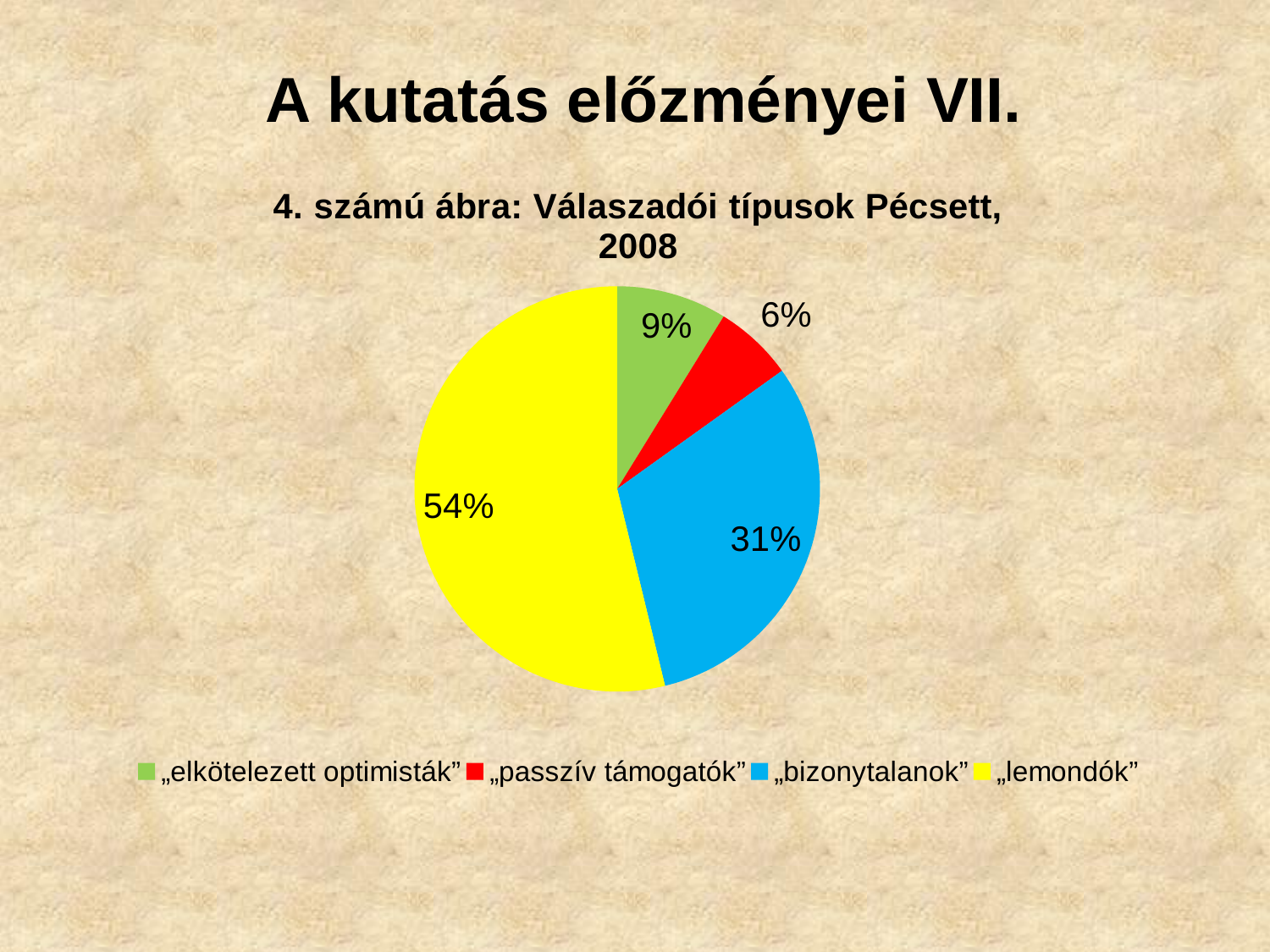
What share of the pie is labelled „bizonytalanok”? 31% Which category has the largest slice of the pie? „lemondók” What is the difference in percentage points between „lemondók” and „bizonytalanok”? 23 Which category has the smallest slice of the pie? „passzív támogatók” What share of the pie is labelled „lemondók”? 54% What type of chart is shown on the slide? pie chart What colour is the slice for „bizonytalanok”? blue How many categories does the legend list? 4 What is the title of the chart? 4. számú ábra: Válaszadói típusok Pécsett, 2008 What share of the pie is labelled „passzív támogatók”? 6% Which is larger, the share for „elkötelezett optimisták” or for „passzív támogatók”? „elkötelezett optimisták”